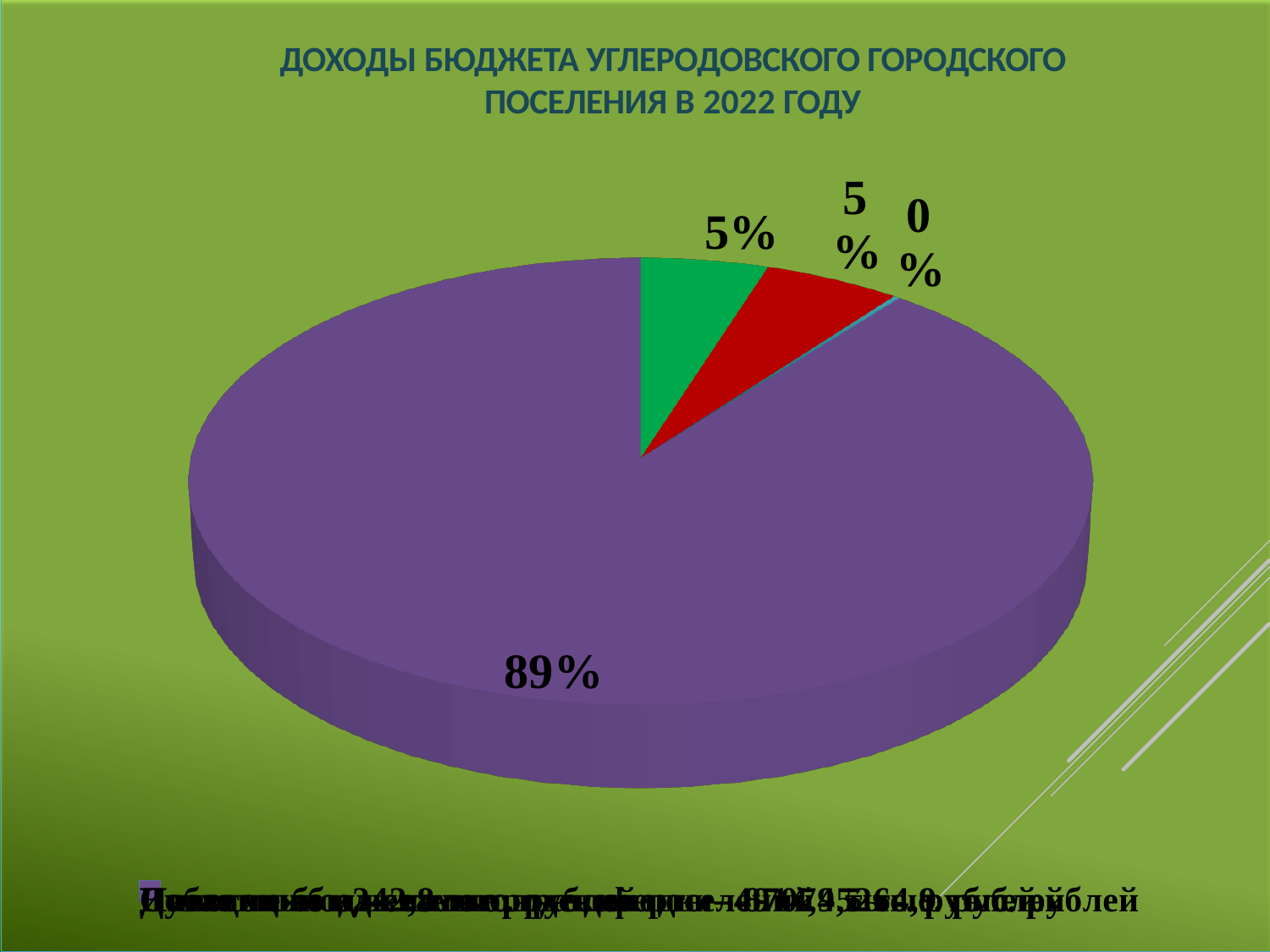
Which colour slice has the largest share of the pie? purple What is the difference in percentage points between the purple slice and the green slice? 84 What percentage is shown for the purple slice of the pie? 89% What kind of chart is shown on the slide? pie chart What is the combined share of the green and red slices? 10% Which colour slice has the smallest share of the pie? blue How many slices does the pie chart have? 4 What percentage is shown for the green slice of the pie? 5% What percentage is shown for the red slice of the pie? 5% What percentage is shown for the smallest (blue) slice of the pie? 0% What is the title of the chart? ДОХОДЫ БЮДЖЕТА УГЛЕРОДОВСКОГО ГОРОДСКОГО ПОСЕЛЕНИЯ В 2022 ГОДУ Which is larger, the purple slice or the red slice? purple